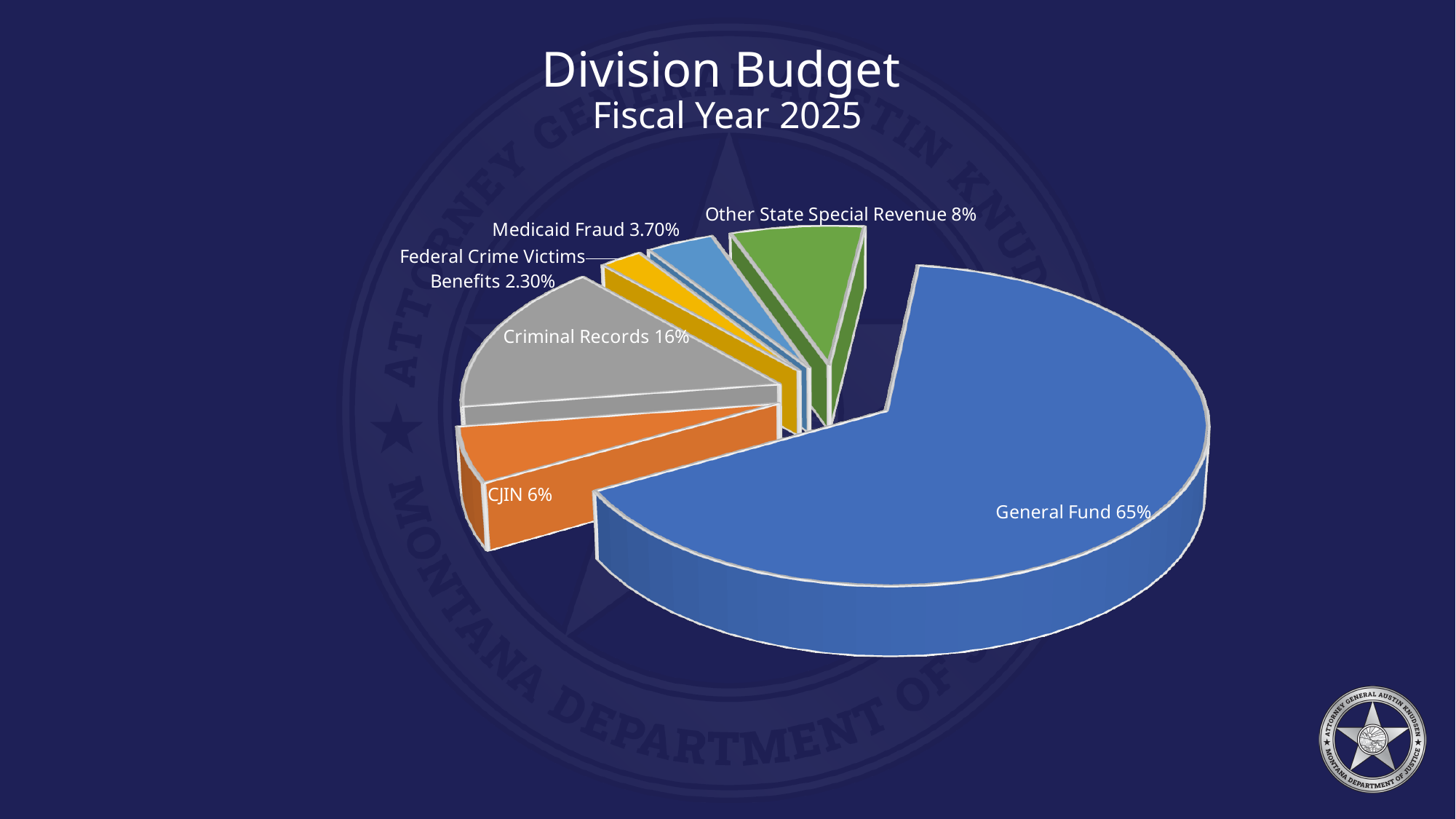
Which category has the smallest share of the budget? Federal Crime Victims Benefits What percentage of the budget is CJIN? 6% What percentage of the budget is Federal Crime Victims Benefits? 2.30% What percentage of the budget is Other State Special Revenue? 8% What percentage of the budget is Medicaid Fraud? 3.70% What share of the Division Budget for Fiscal Year 2025 is the General Fund? 65% What kind of chart is shown on the slide? Pie chart Which is larger, the share for Criminal Records or the share for Other State Special Revenue? Criminal Records What is the difference in percentage points between the General Fund share and the Criminal Records share? 49 Which category has the largest share of the budget? General Fund How many categories are shown in the pie chart? 6 What percentage of the budget is Criminal Records? 16%